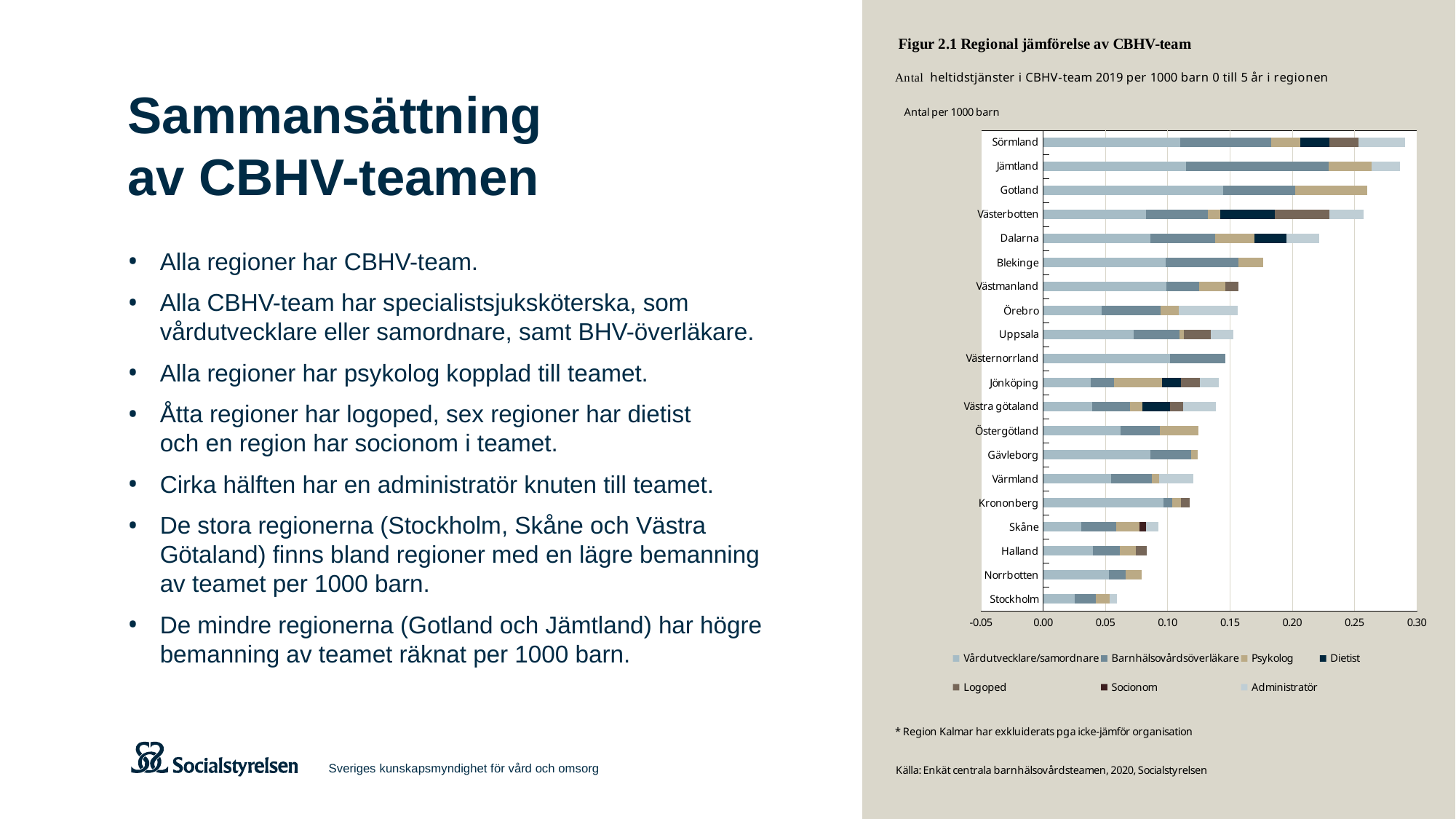
Is the total value for Dalarna greater or less than 0.20? greater Is the total value for Sörmland greater or less than 0.25? greater Is the total value for Stockholm greater or less than 0.10? less What is the title of the figure on the slide? Figur 2.1 Regional jämförelse av CBHV-team Which region has a larger total bar, Gotland or Stockholm? Gotland Which region has a larger total bar, Blekinge or Halland? Blekinge How many series does the chart's legend list? 7 How many regions are listed on the chart's vertical axis? 20 What kind of chart is shown on the slide? Stacked bar chart Are the regions ordered from largest to smallest total going from top to bottom of the chart? Yes Which region has the lowest total number of full-time positions per 1000 children? Stockholm